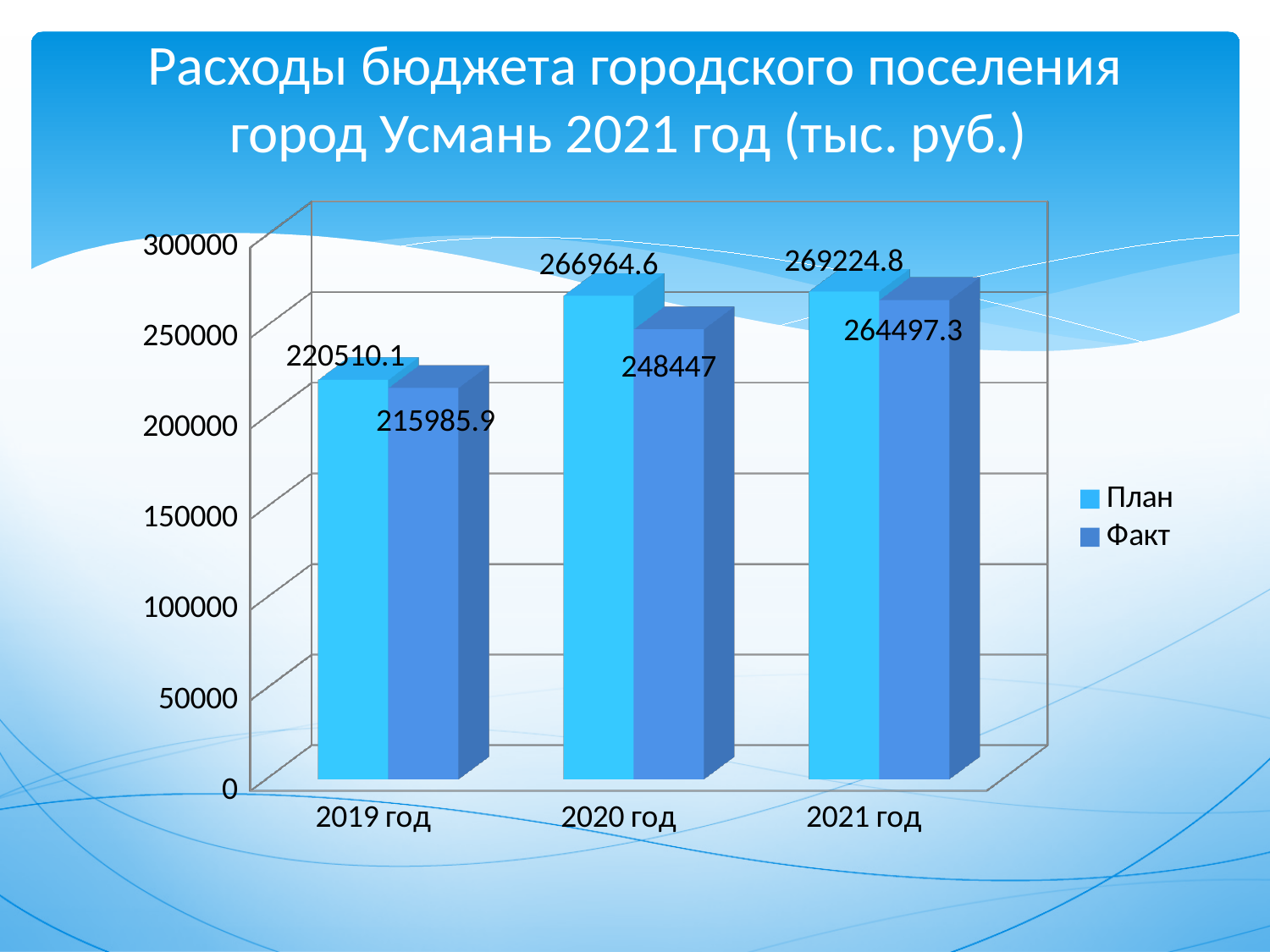
What is the difference between the План and Факт values for 2019 год? 4524.2 Which is larger for 2021 год, the План value or the Факт value? План How many years are shown on the x axis? 3 What is the Факт value for 2021 год? 264497.3 What is the Факт value for 2019 год? 215985.9 Do the Факт values rise or fall from 2019 год to 2021 год? rise What is the difference between the План and Факт values for 2020 год? 18517.6 What is the План value for 2020 год? 266964.6 Which year has the highest План value? 2021 год How many series does the legend list? 2 Which year has the lowest Факт value? 2019 год What is the План value for 2019 год? 220510.1